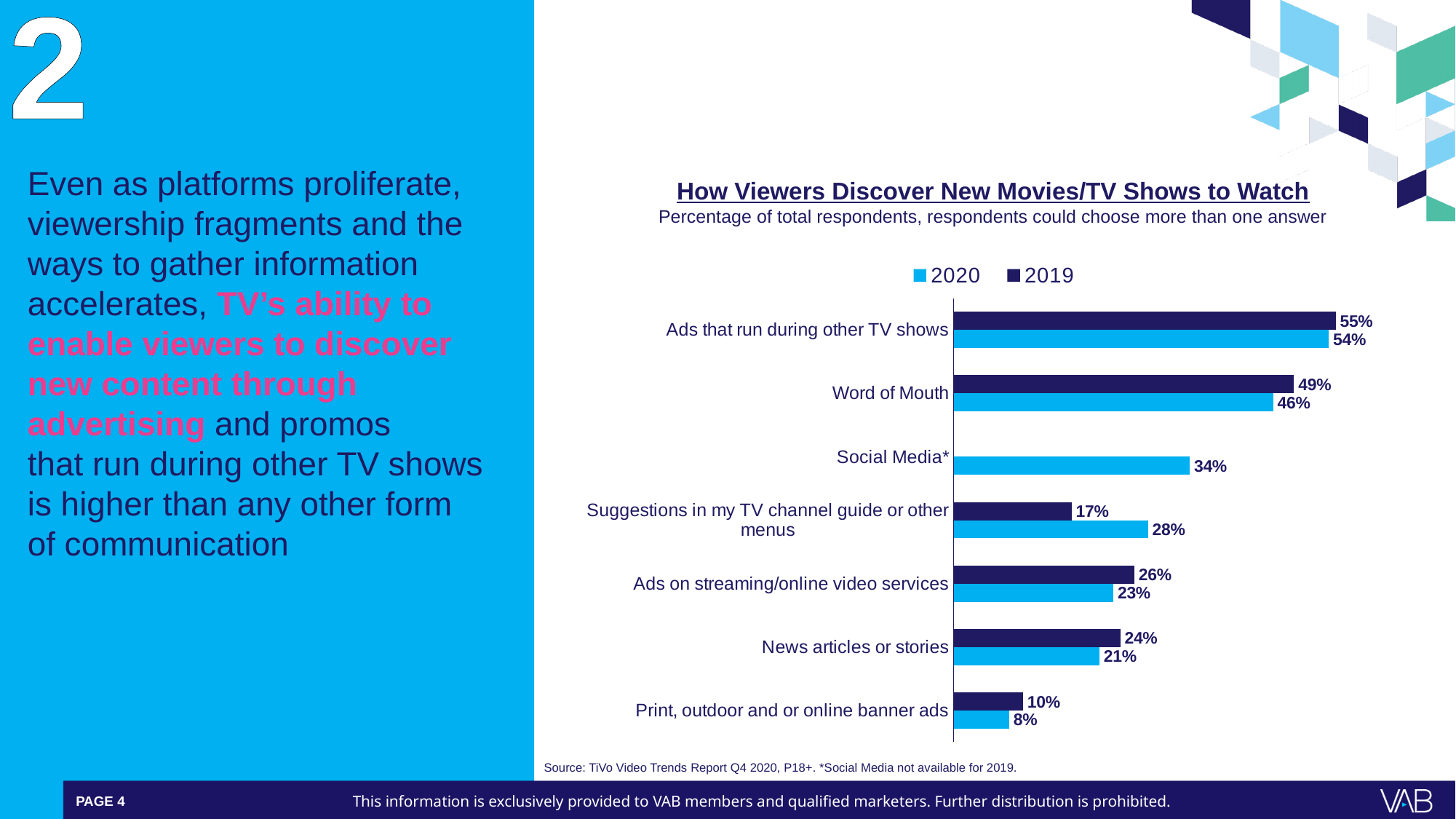
What is the title of the chart? How Viewers Discover New Movies/TV Shows to Watch What kind of chart is shown on the slide? Bar chart Which category has the highest 2020 value? Ads that run during other TV shows What is the 2019 value for Suggestions in my TV channel guide or other menus? 17% What is the difference between the 2020 and 2019 values for Suggestions in my TV channel guide or other menus? 11% How many categories are shown on the chart? 7 What is the 2020 value for Word of Mouth? 46% Which is larger for News articles or stories, the 2020 value or the 2019 value? 2019 Which category has the lowest 2019 value? Print, outdoor and or online banner ads How many series does the legend list? 2 What is the 2019 value for Ads that run during other TV shows? 55% What is the 2020 value for Social Media*? 34%